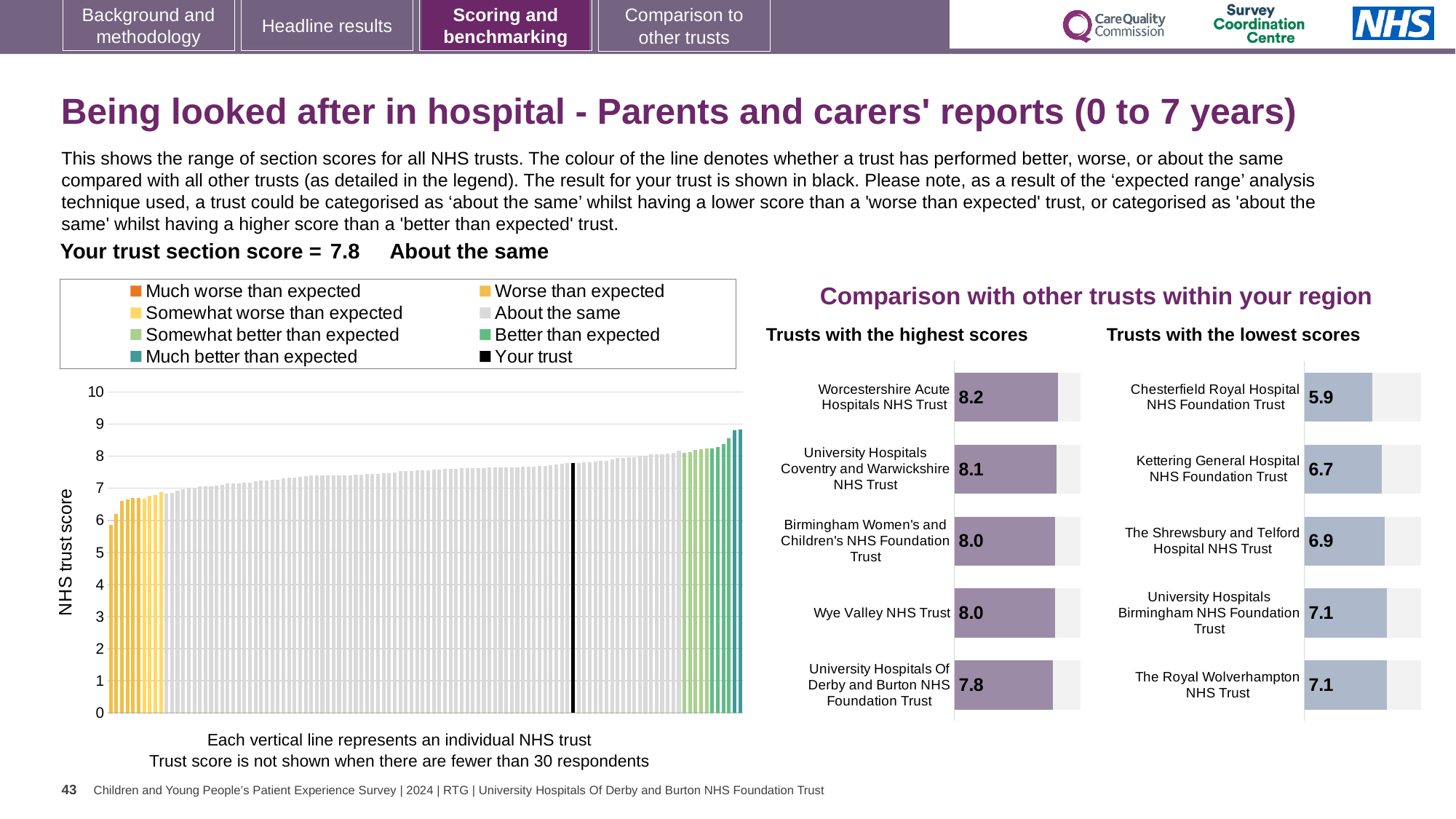
How many entries does the legend of the large chart on the left list? 8 In the 'Trusts with the highest scores' chart, which trust has the lowest score shown? University Hospitals Of Derby and Burton NHS Foundation Trust What type of chart is the large chart on the left showing NHS trust scores? Bar chart In the 'Trusts with the lowest scores' chart, what is the difference between the scores of Kettering General Hospital NHS Foundation Trust and Chesterfield Royal Hospital NHS Foundation Trust? 0.8 In the 'Trusts with the lowest scores' chart, what is the score for Chesterfield Royal Hospital NHS Foundation Trust? 5.9 In the large chart on the left, do the trust scores rise or fall from left to right? Rise In the 'Trusts with the lowest scores' chart, which trust has the lowest score? Chesterfield Royal Hospital NHS Foundation Trust In the 'Trusts with the lowest scores' chart, which has the higher score: Kettering General Hospital NHS Foundation Trust or The Shrewsbury and Telford Hospital NHS Trust? The Shrewsbury and Telford Hospital NHS Trust In the 'Trusts with the highest scores' chart, what is the score for Worcestershire Acute Hospitals NHS Trust? 8.2 In the 'Trusts with the lowest scores' chart, what score do University Hospitals Birmingham NHS Foundation Trust and The Royal Wolverhampton NHS Trust both have? 7.1 How many trusts are listed in the 'Trusts with the highest scores' chart? 5 In the 'Trusts with the highest scores' chart, what is the difference between the scores of Worcestershire Acute Hospitals NHS Trust and University Hospitals Of Derby and Burton NHS Foundation Trust? 0.4